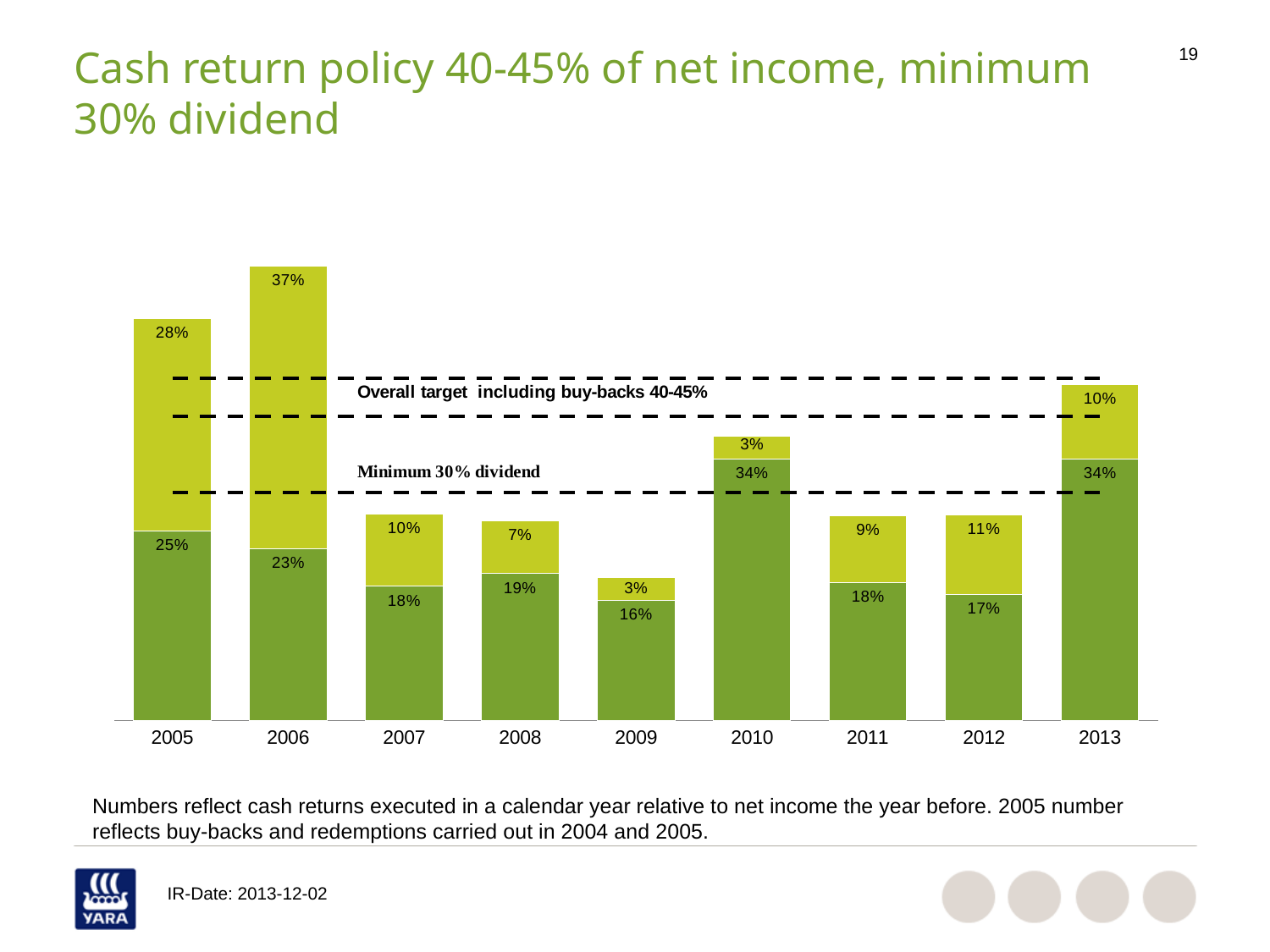
Which year has the larger dark green (lower) segment, 2007 or 2008? 2008 How many years are shown on the x axis? 9 What is the total of the stacked bar for 2013? 44% What is the value of the light green (upper) segment for 2006? 37% Which year has the smallest dark green (lower) segment? 2009 What kind of chart is shown on the slide? Stacked bar chart Which year has the largest light green (upper) segment? 2006 What is the total of the stacked bar for 2005? 53% In 2006, how much larger is the light green segment than the dark green segment? 14 percentage points Does the light green (upper) segment rise or fall from 2006 to 2009? Fall What does the upper pair of dashed lines on the chart represent? Overall target including buy-backs 40-45% What is the value of the dark green (lower) segment for 2010? 34%